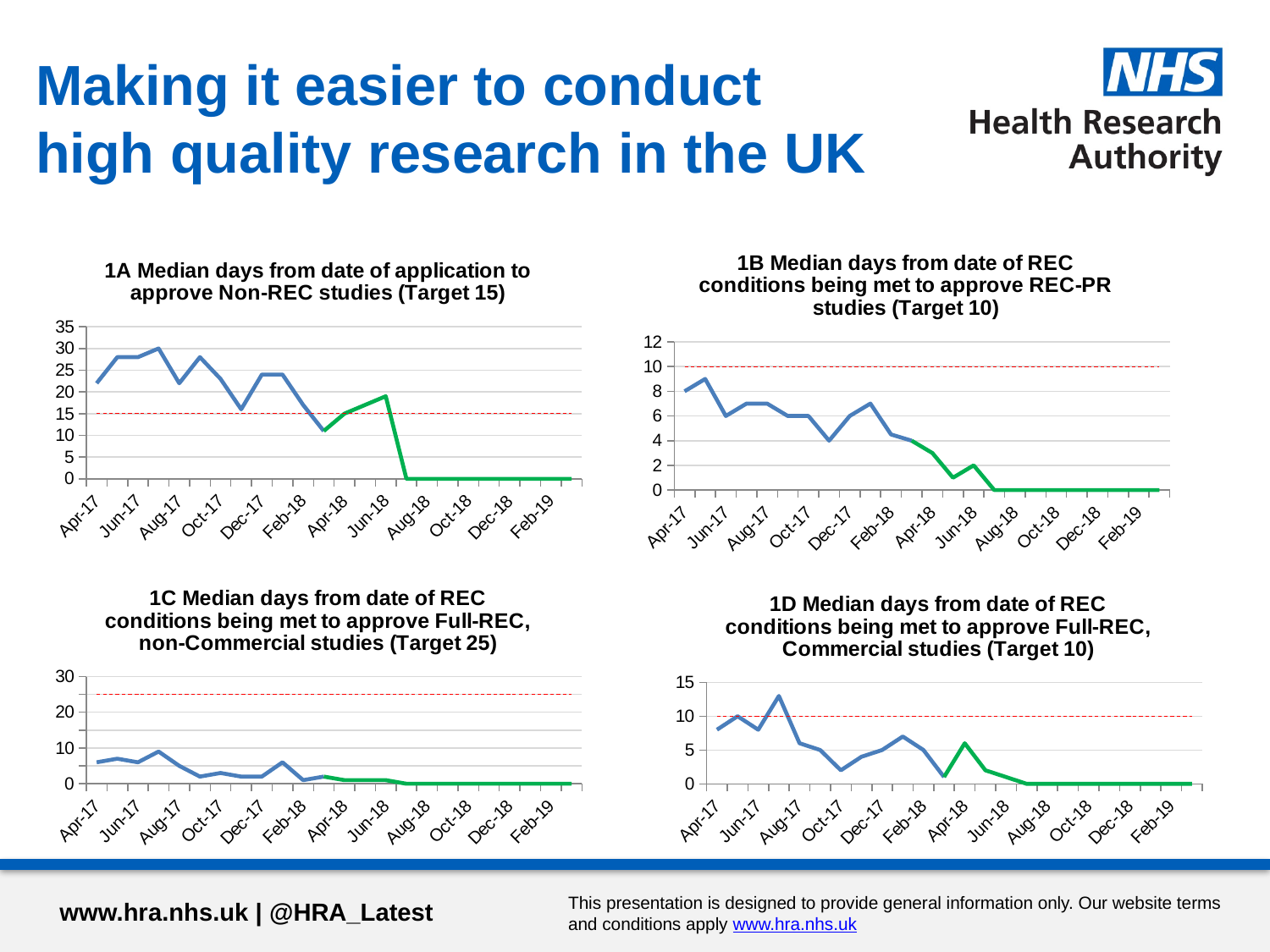
In chart 1B (REC-PR studies), is the value for Nov-17 greater or less than 6? less In chart 1B (REC-PR studies), what is the value for Apr-17? 8 What target value is stated in the title of chart 1C? 25 In chart 1A (Non-REC studies), is the value for Jun-17 greater or less than 15? greater In chart 1D (Full-REC, Commercial studies), is the value for Jul-17 greater or less than 10? greater What kind of chart is chart 1A (Median days from date of application to approve Non-REC studies)? Line chart How many charts are shown on the slide? 4 In chart 1B (REC-PR studies), which month has the highest value? May-17 In chart 1D (Full-REC, Commercial studies), which month has the highest value? Jul-17 In chart 1A (Non-REC studies), what is the value for Aug-18? 0